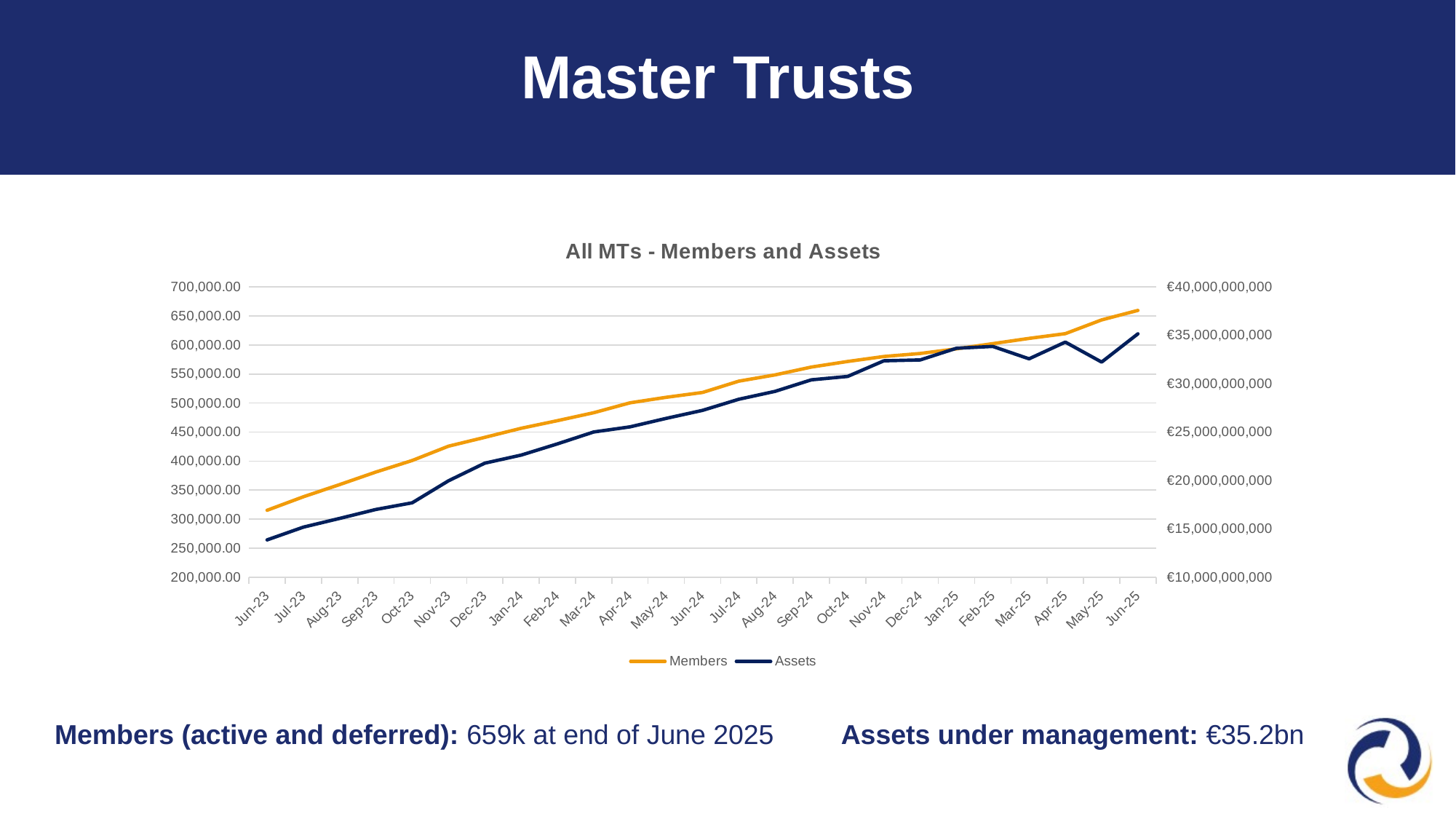
What kind of chart is shown on the slide? line chart What is the title of the chart? All MTs - Members and Assets In which month is the Members value lowest? Jun-23 Is the Members value for Jun-25 greater or less than 600,000.00? greater Do the Members values rise or fall from Jun-23 to Jun-25? rise How many monthly points are plotted along the x axis? 25 How many series does the legend list? 2 Is the Members value for Jun-23 greater or less than 350,000.00? less Is the Assets value for Jun-25 greater or less than €30,000,000,000? greater In which month is the Members value highest? Jun-25 In which month is the Assets value lowest? Jun-23 What colour is the Members line? orange